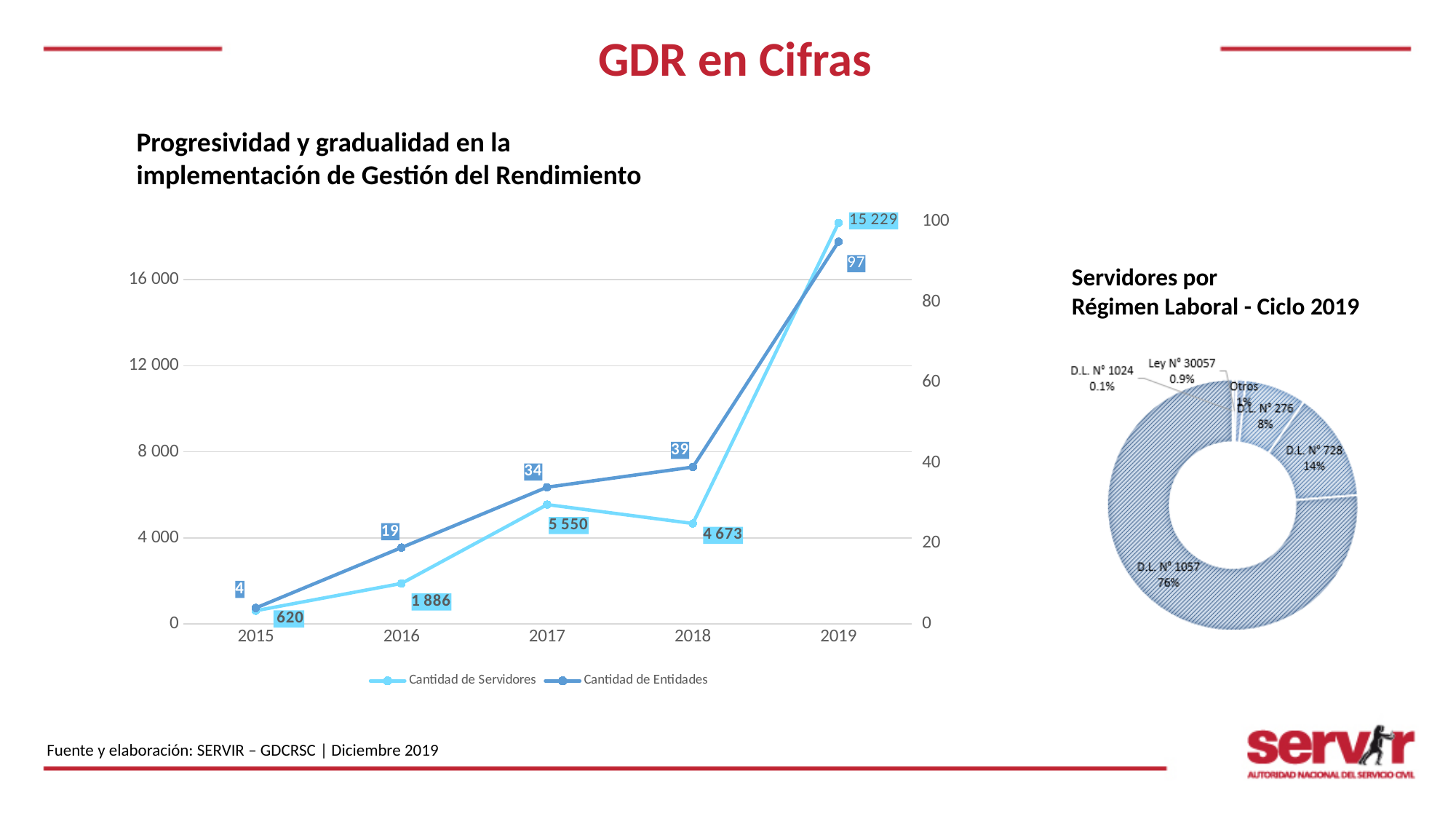
In the line chart 'Progresividad y gradualidad en la implementación de Gestión del Rendimiento', what is the difference in Cantidad de Entidades between 2018 and 2017? 5 In the line chart 'Progresividad y gradualidad en la implementación de Gestión del Rendimiento', how many years are shown on the x axis? 5 What kind of chart is 'Progresividad y gradualidad en la implementación de Gestión del Rendimiento'? Line chart In the doughnut chart 'Servidores por Régimen Laboral - Ciclo 2019', which régimen has the smallest share? D.L. N° 1024 In the line chart 'Progresividad y gradualidad en la implementación de Gestión del Rendimiento', which year has the highest Cantidad de Entidades? 2019 In the line chart 'Progresividad y gradualidad en la implementación de Gestión del Rendimiento', is the Cantidad de Servidores larger in 2017 or in 2018? 2017 In the line chart 'Progresividad y gradualidad en la implementación de Gestión del Rendimiento', what is the Cantidad de Servidores in 2019? 15 229 In the doughnut chart 'Servidores por Régimen Laboral - Ciclo 2019', what share does D.L. N° 1057 have? 76% In the line chart 'Progresividad y gradualidad en la implementación de Gestión del Rendimiento', how many series does the legend list? 2 In the doughnut chart 'Servidores por Régimen Laboral - Ciclo 2019', what is the share for D.L. N° 728? 14% In the line chart 'Progresividad y gradualidad en la implementación de Gestión del Rendimiento', what is the Cantidad de Entidades in 2017? 34 In the line chart 'Progresividad y gradualidad en la implementación de Gestión del Rendimiento', which year has the lowest Cantidad de Servidores? 2015